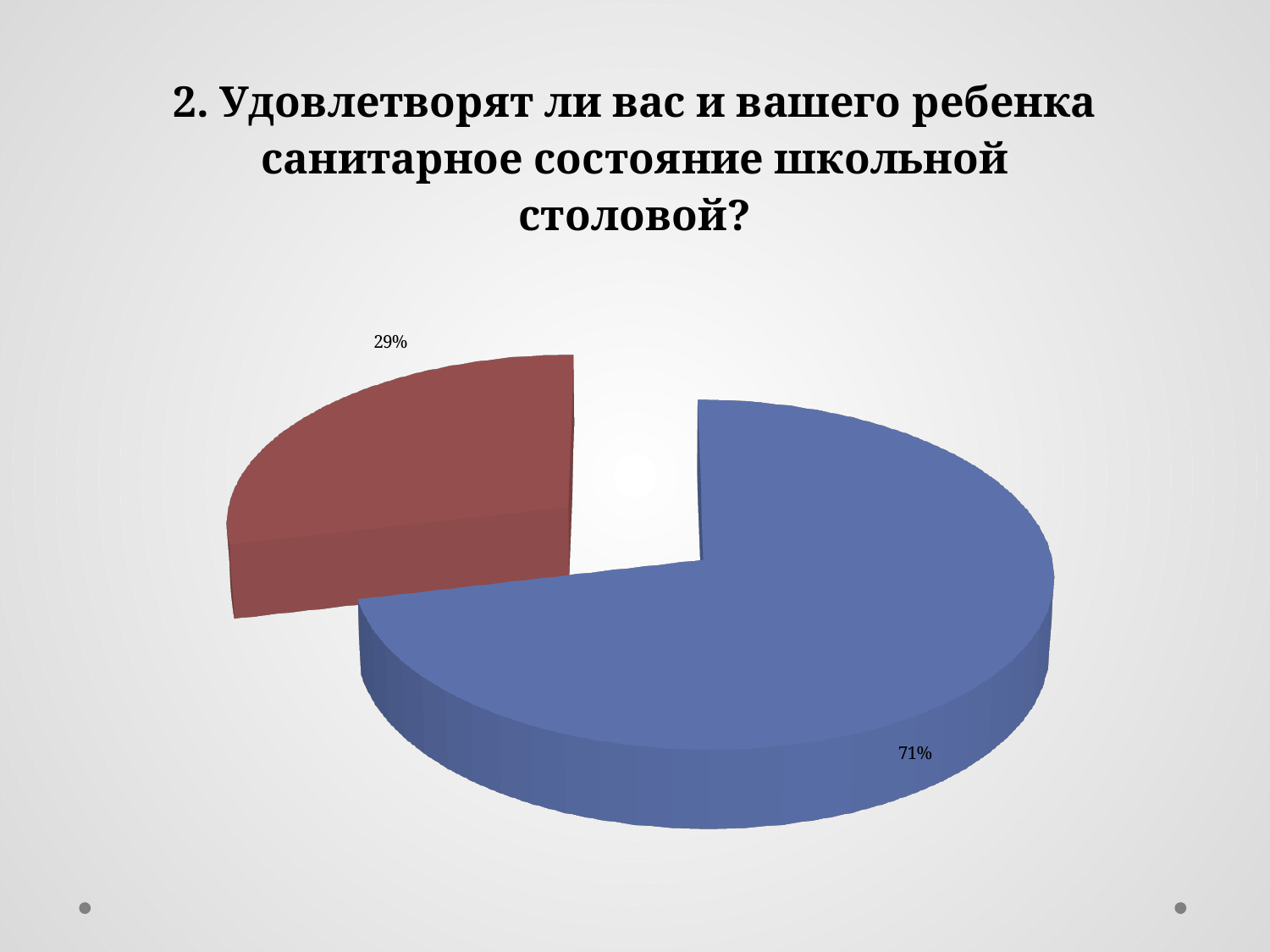
What do the two slice percentages add up to? 100% What is the difference in percentage points between the blue slice and the red slice? 42 Which slice of the pie chart is the smallest? the red slice (29%) What kind of chart is shown on the slide? pie chart Which is larger, the blue slice or the red slice? the blue slice What percentage is shown on the blue slice of the pie chart? 71% Does the pie chart have a legend? No Is the value of the red slice greater or less than 50%? less Which slice of the pie chart is the largest? the blue slice (71%) How many slices does the pie chart have? 2 What percentage is shown on the red slice of the pie chart? 29% Is the value of the blue slice greater or less than 50%? greater